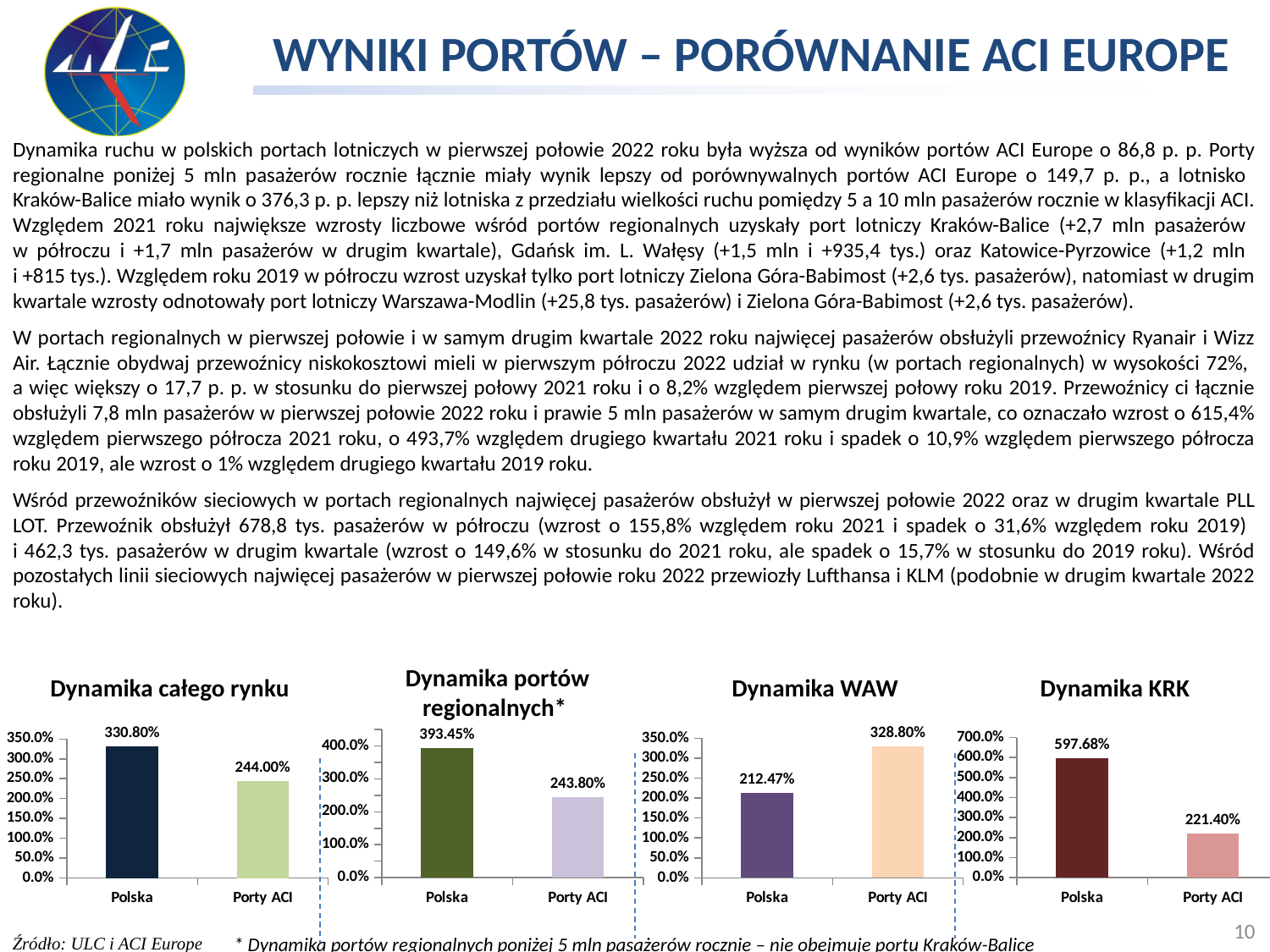
In the 'Dynamika całego rynku' chart, what is the value for Porty ACI? 244.00% In the 'Dynamika portów regionalnych*' chart, what is the value for Polska? 393.45% In the 'Dynamika WAW' chart, what is the value for Porty ACI? 328.80% What type of chart is 'Dynamika WAW'? Bar chart In the 'Dynamika WAW' chart, which category has the higher value, Polska or Porty ACI? Porty ACI In the 'Dynamika KRK' chart, which category has the lowest value? Porty ACI How many charts are shown at the bottom of the slide? 4 In the 'Dynamika całego rynku' chart, what is the value for Polska? 330.80% In the 'Dynamika KRK' chart, what is the value for Polska? 597.68% How many categories are shown in the 'Dynamika portów regionalnych*' chart? 2 In the 'Dynamika KRK' chart, what is the difference between the Polska value and the Porty ACI value? 376.28% In the 'Dynamika całego rynku' chart, what is the difference between the Polska value and the Porty ACI value? 86.80%